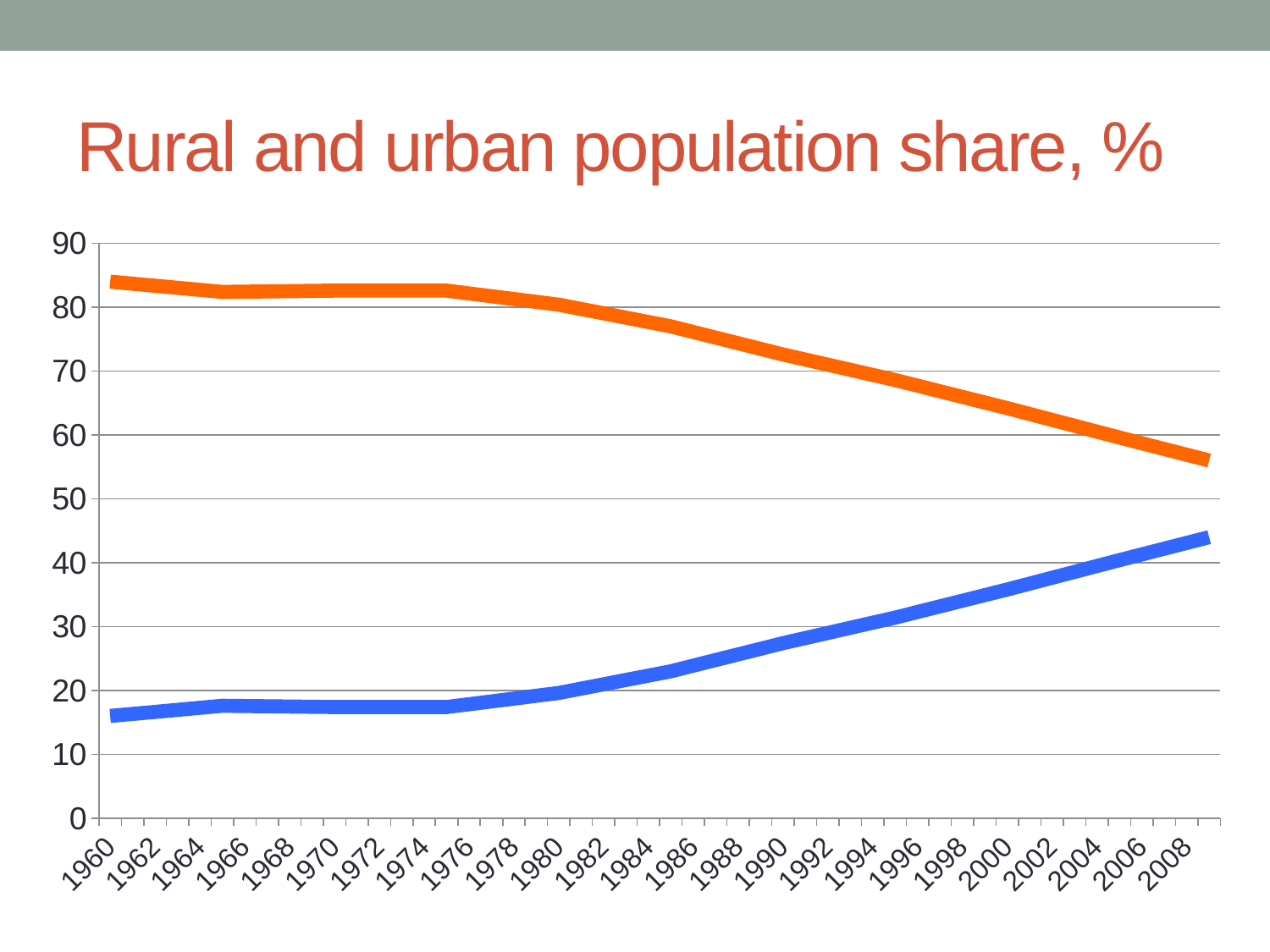
Is the value of the orange line in 1960 greater or less than 80? greater In 2008, which line has the higher value, the orange line or the blue line? orange line Is the value of the blue line in 2008 greater or less than 40? greater Is the value of the blue line in 1980 greater or less than 30? less Does the blue line rise or fall from 1960 to 2008? rise What is the highest value shown on the y axis? 90 How many year labels are shown on the x axis? 25 What kind of chart is shown on the slide? line chart What is the title of the chart? Rural and urban population share, % Does the orange line rise or fall from 1960 to 2008? fall